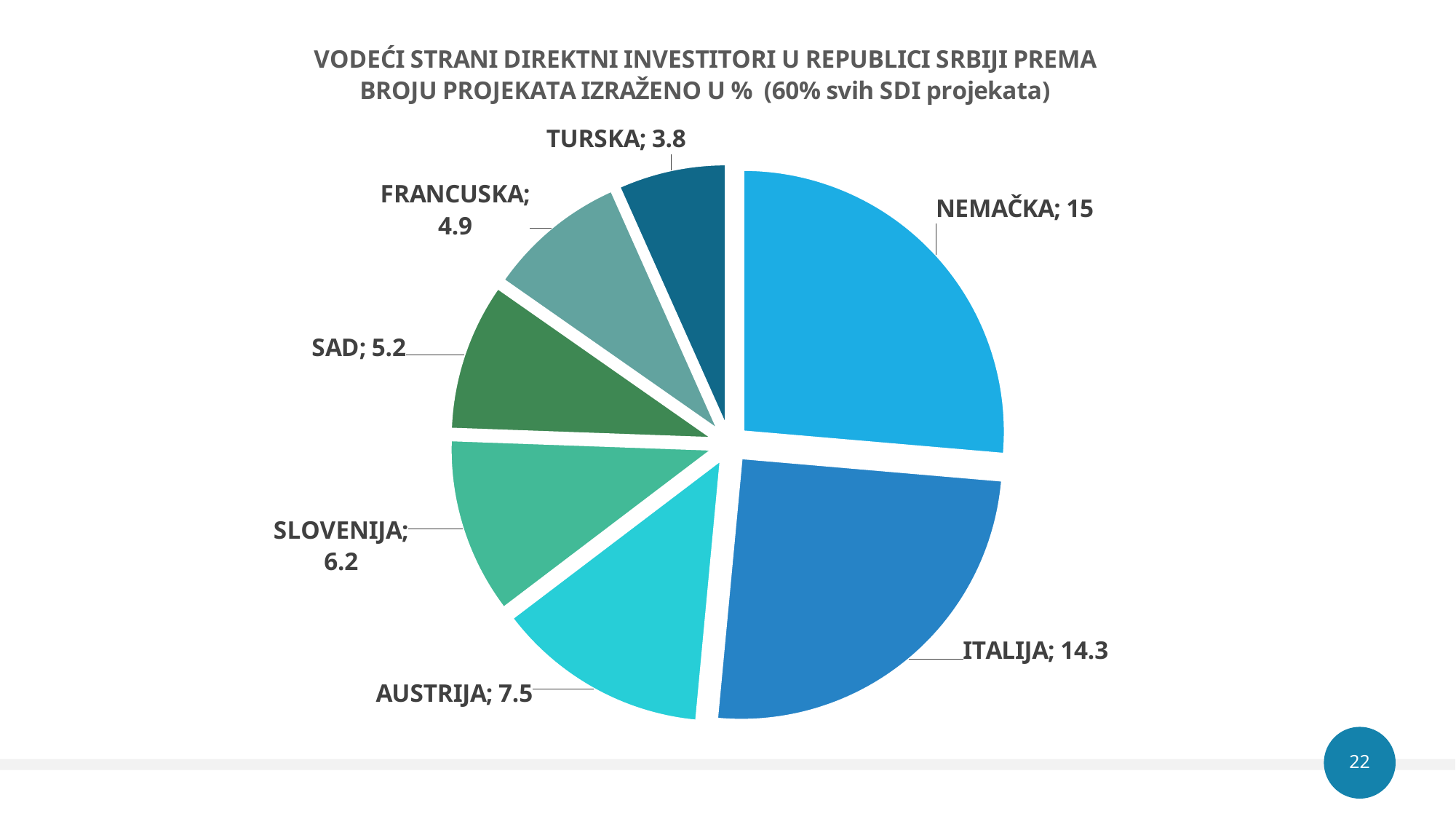
What is the difference between the values for NEMAČKA and ITALIJA? 0.7 Which has a larger value, SAD or FRANCUSKA? SAD Which country has the largest slice in the pie chart? NEMAČKA How many slices does the pie chart have? 7 Which country has the smallest slice in the pie chart? TURSKA What is the value shown for SLOVENIJA? 6.2 What percentage of all SDI projects does the chart title say the shown investors account for? 60% What type of chart is shown on the slide? pie chart What is the value shown for ITALIJA? 14.3 What is the value shown for AUSTRIJA? 7.5 What is the value shown for NEMAČKA? 15 What is the value shown for TURSKA? 3.8